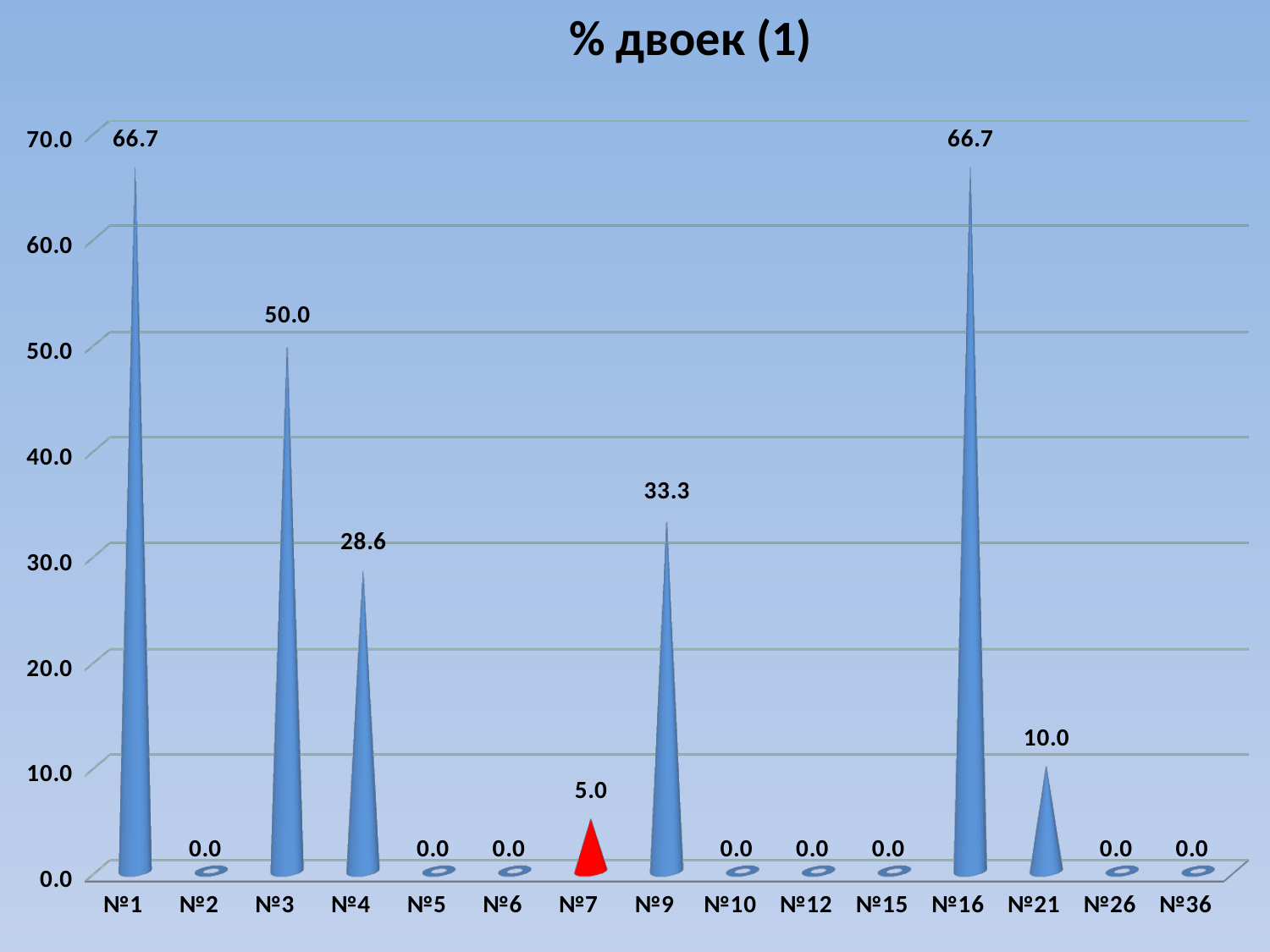
Which category's bar is coloured red? №7 What is the value for №4? 28.6 What is the value for №21? 10.0 Which has a larger value, №4 or №9? №9 What is the difference between the values for №3 and №4? 21.4 What is the value for №1? 66.7 What is the highest value shown on the chart? 66.7 How many categories are shown on the x axis? 15 What is the difference between the values for №9 and №21? 23.3 What is the value for №7? 5.0 What is the value for №9? 33.3 What kind of chart is this? Bar chart